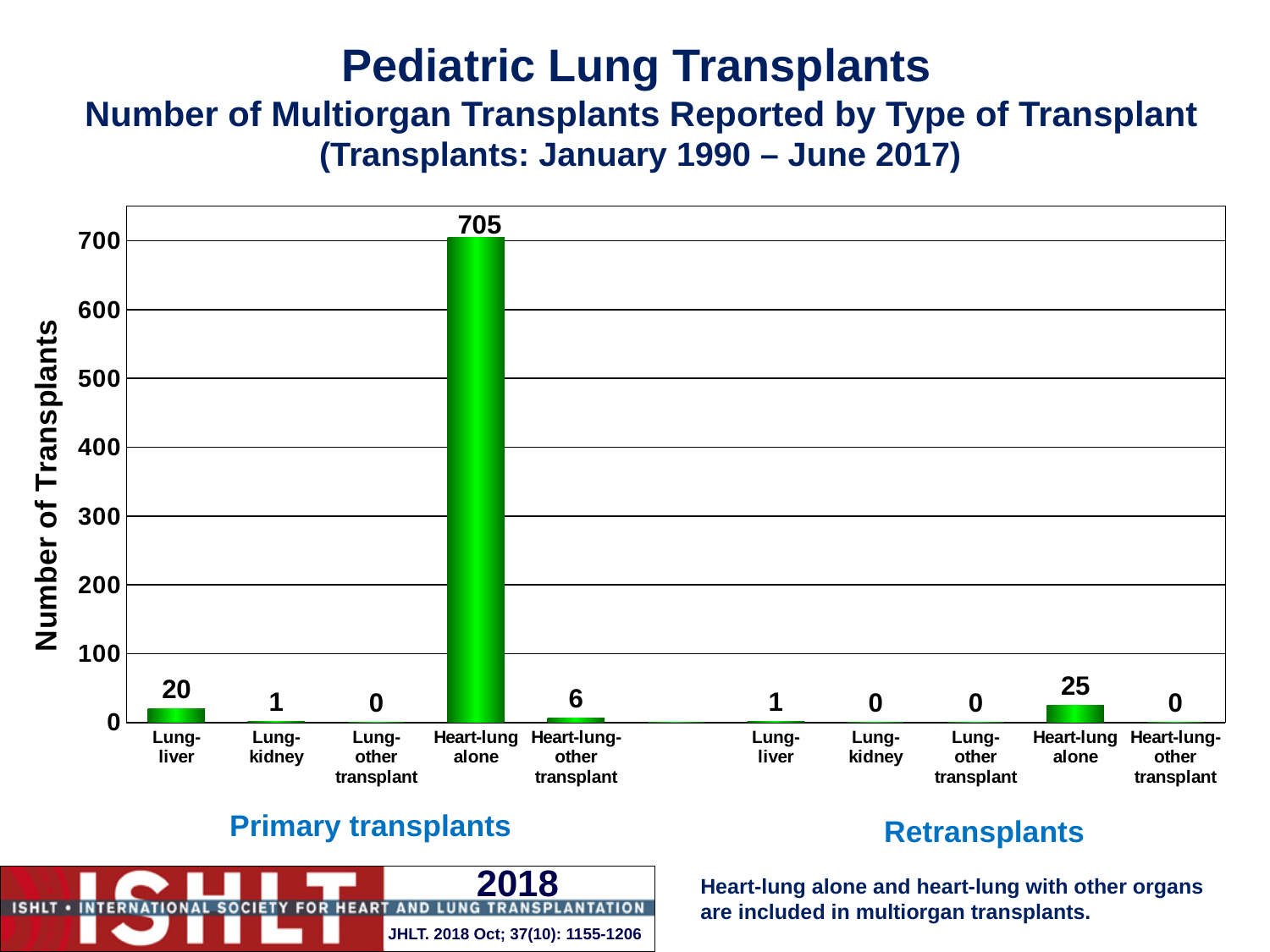
How many categories have a value of 0 on the chart? 4 What is the number of Heart-lung alone retransplants? 25 What are the two groups of bars labelled on the chart? Primary transplants and Retransplants What type of chart is shown on the slide? Bar chart What is the number of Lung-liver primary transplants? 20 Which category has the highest number of transplants on the chart? Heart-lung alone (Primary transplants) What is the label of the y-axis? Number of Transplants How many Heart-lung alone primary transplants are shown? 705 Which is larger: Lung-liver primary transplants or Lung-liver retransplants? Lung-liver primary transplants What is the number of Heart-lung-other transplant primary transplants? 6 What is the difference between Heart-lung alone primary transplants and Heart-lung alone retransplants? 680 What is the total number of primary multiorgan transplants shown across all five categories? 732